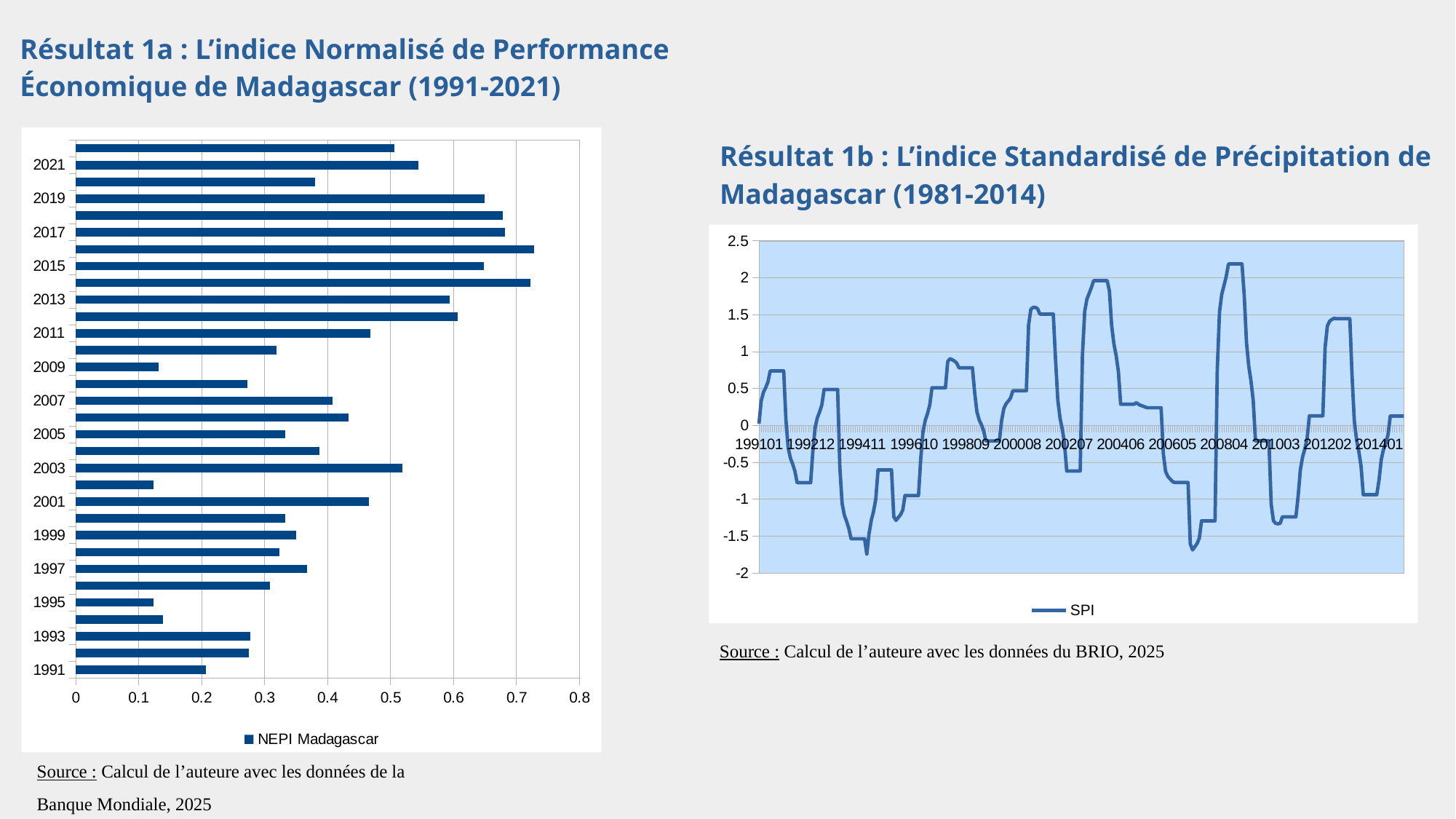
In the left chart (Résultat 1a), which year has the larger value, 2017 or 1991? 2017 In the left chart (Résultat 1a), is the value for 2003 greater or less than 0.5? greater What kind of chart is the left chart titled 'Résultat 1a'? bar chart What kind of chart is the right chart titled 'Résultat 1b'? line chart In the left chart (Résultat 1a), how many bars (years) are plotted? 32 In the right chart (Résultat 1b), what is the name of the series shown in the legend? SPI In the left chart (Résultat 1a), is the value for 2017 greater or less than 0.6? greater In the left chart (Résultat 1a), which year has the larger value, 2009 or 2003? 2003 In the left chart (Résultat 1a), how many series does the legend list? 1 In the left chart (Résultat 1a), is the value for 2009 greater or less than 0.2? less